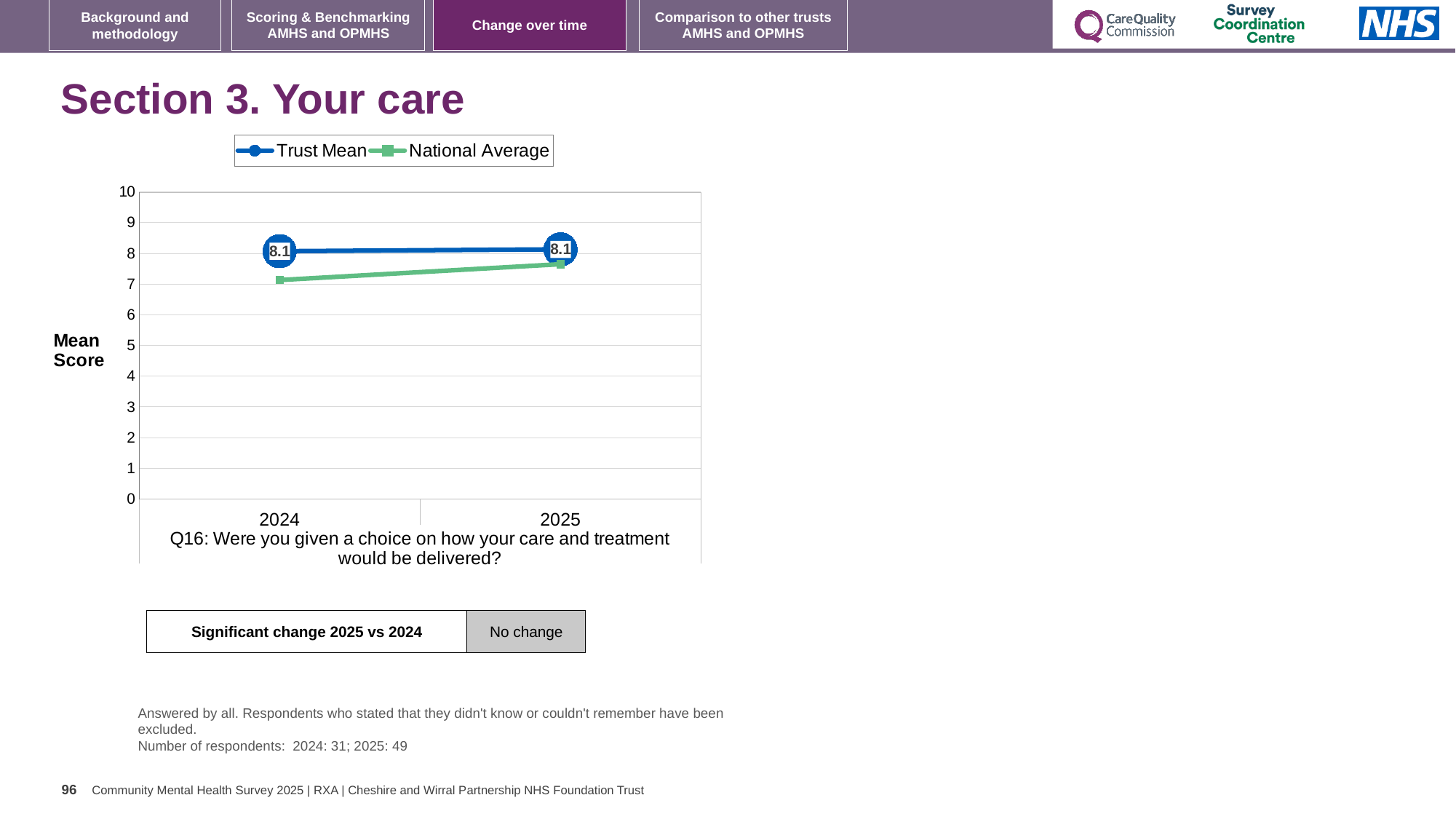
What is the Trust Mean value for 2025? 8.1 What is the label on the y axis of the chart? Mean Score Is the National Average value for 2024 greater or less than 8? less What kind of chart is shown on the slide? Line chart How many years are plotted on the x axis? 2 In 2024, which is larger: the Trust Mean or the National Average? Trust Mean Does the National Average rise or fall from 2024 to 2025? Rise How many series does the legend list? 2 In which year is the National Average higher? 2025 Is the National Average value for 2025 greater or less than 7? greater What is the Trust Mean value for 2024? 8.1 What is the difference between the Trust Mean in 2025 and the Trust Mean in 2024? 0